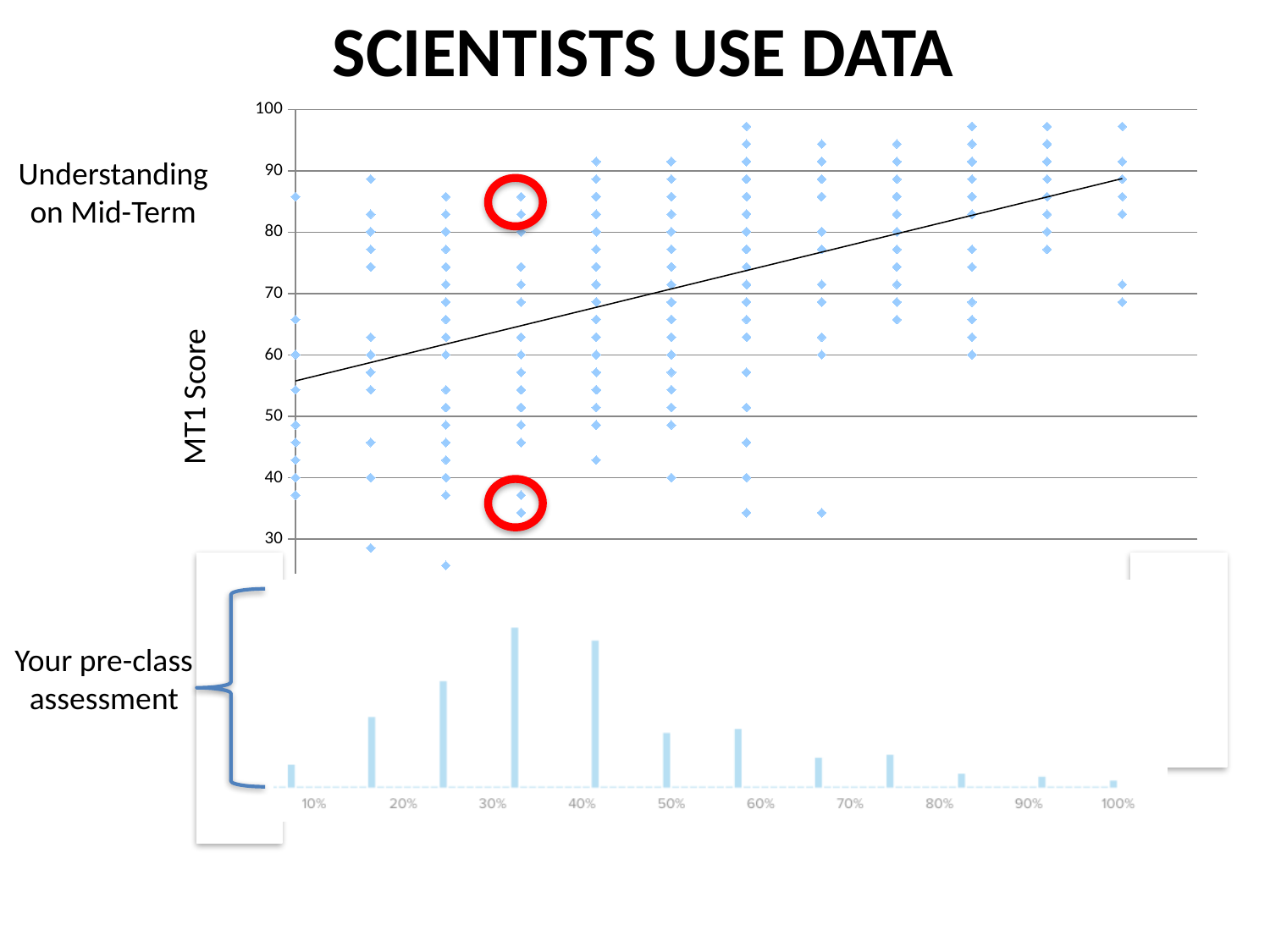
What is the lowest value shown on the y axis of the upper scatter plot? 30 How many bars are plotted in the lower bar chart? 12 What is the y-axis label of the upper scatter plot? MT1 Score In the upper scatter plot, is the trend line's value at the left edge of the plot greater or less than 50? greater In the lower bar chart, which x-axis position has the tallest bar? 30% What kind of chart is the upper chart on the slide? scatter plot In the lower bar chart, is the bar near 20% taller or shorter than the bar near 40%? shorter In the lower bar chart, is the bar near 30% taller or shorter than the bar near 50%? taller What kind of chart is the lower chart on the slide? bar chart How many percentage tick labels are shown on the x axis of the lower bar chart? 10 In the upper scatter plot, does the fitted trend line rise or fall as the x value increases? rises What is the highest value shown on the y axis of the upper scatter plot? 100